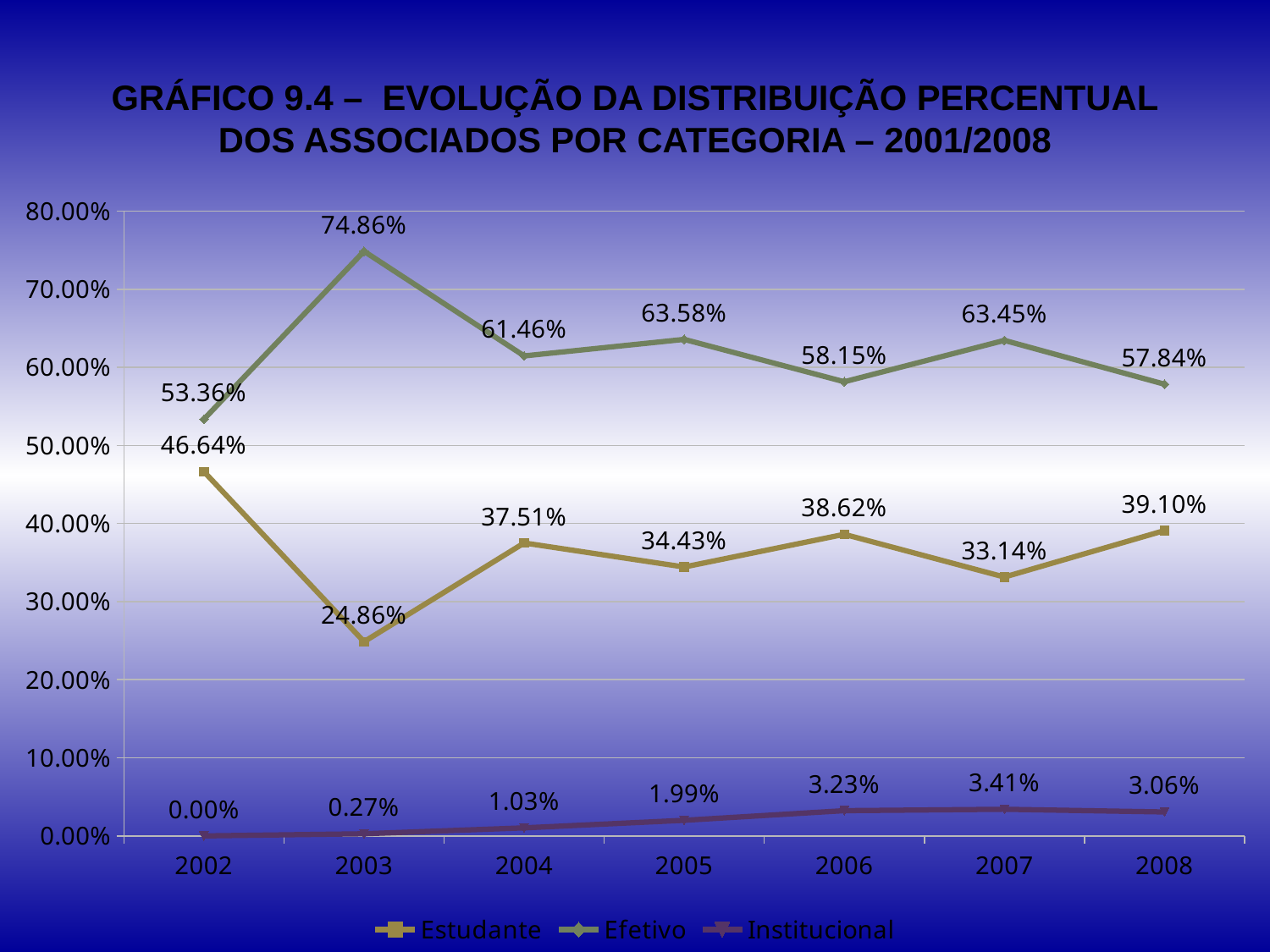
What is the value for Efetivo in 2003? 74.86% What is the value for Institucional in 2006? 3.23% What is the value for Estudante in 2008? 39.10% Which series is plotted with the green line? Efetivo What type of chart is shown on the slide? line chart Does the Institucional series rise or fall from 2002 to 2007? rise Which is larger in 2005, the Estudante value or the Efetivo value? Efetivo In which year is the Efetivo series at its highest? 2003 How many years are shown on the x axis? 7 What is the difference between the Efetivo and Estudante values in 2002? 6.72% How many series does the legend list? 3 In which year is the Estudante series at its lowest? 2003